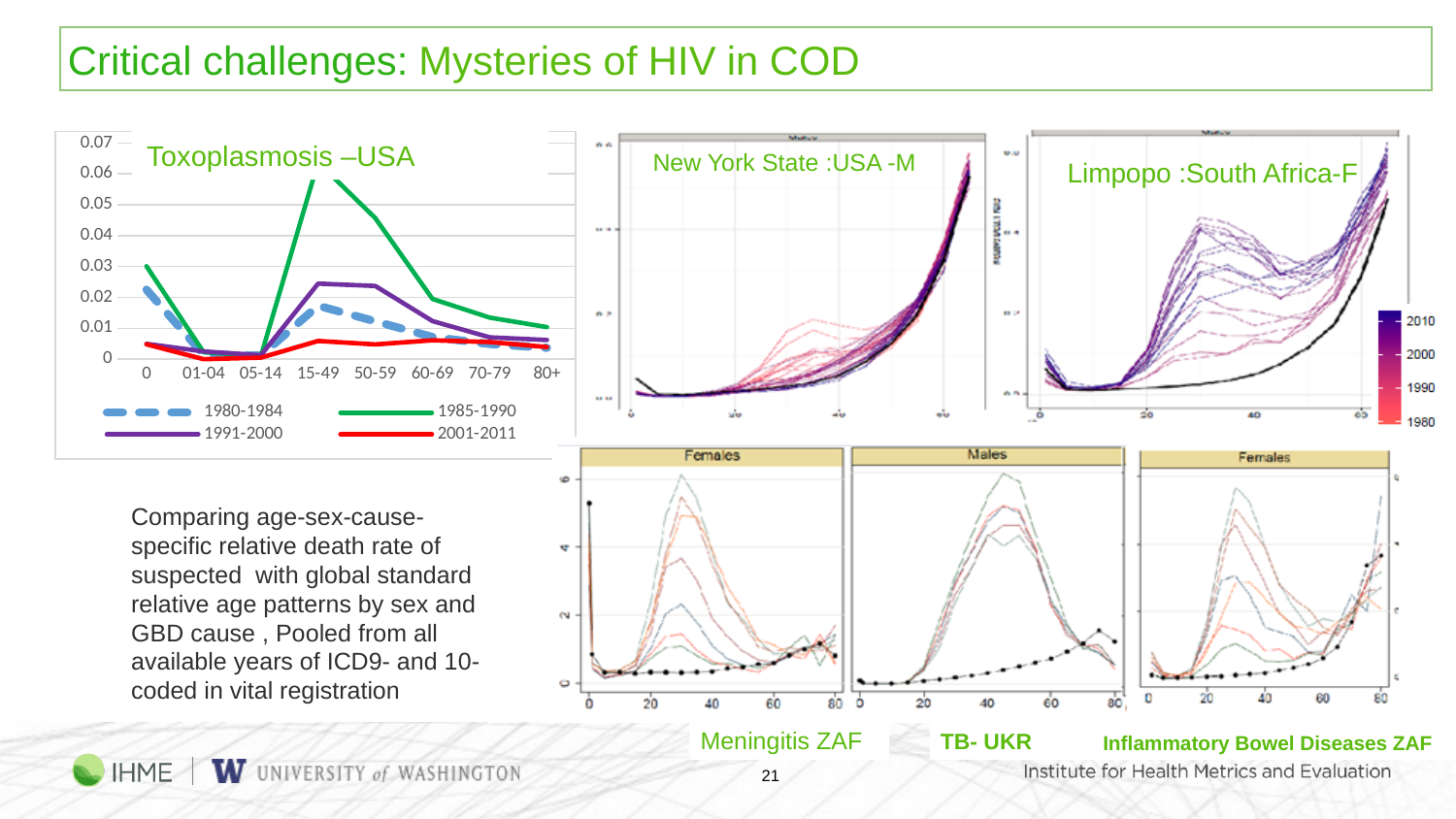
How many age categories are shown on the x axis of the Toxoplasmosis –USA chart? 8 In the Toxoplasmosis –USA chart, is the value for 1985-1990 at age 0 greater or less than 0.04? less In the Toxoplasmosis –USA chart, is the value for 2001-2011 at age 15-49 greater or less than 0.01? less In the Toxoplasmosis –USA chart, which series has the highest value at age 15-49? 1985-1990 In the Toxoplasmosis –USA chart, at age 15-49, which is larger: 1991-2000 or 2001-2011? 1991-2000 What kind of chart is the Toxoplasmosis –USA chart? line chart In the Toxoplasmosis –USA chart, does the 1985-1990 series rise or fall from age 15-49 to 80+? fall In the Toxoplasmosis –USA chart, is the value for 1985-1990 at age 15-49 greater or less than 0.05? greater How many series does the legend of the Toxoplasmosis –USA chart list? 4 Which years are listed in the colour legend of the Limpopo :South Africa-F chart? 2010, 2000, 1990, 1980 What is the label of the bottom-middle chart (Males panel)? TB- UKR